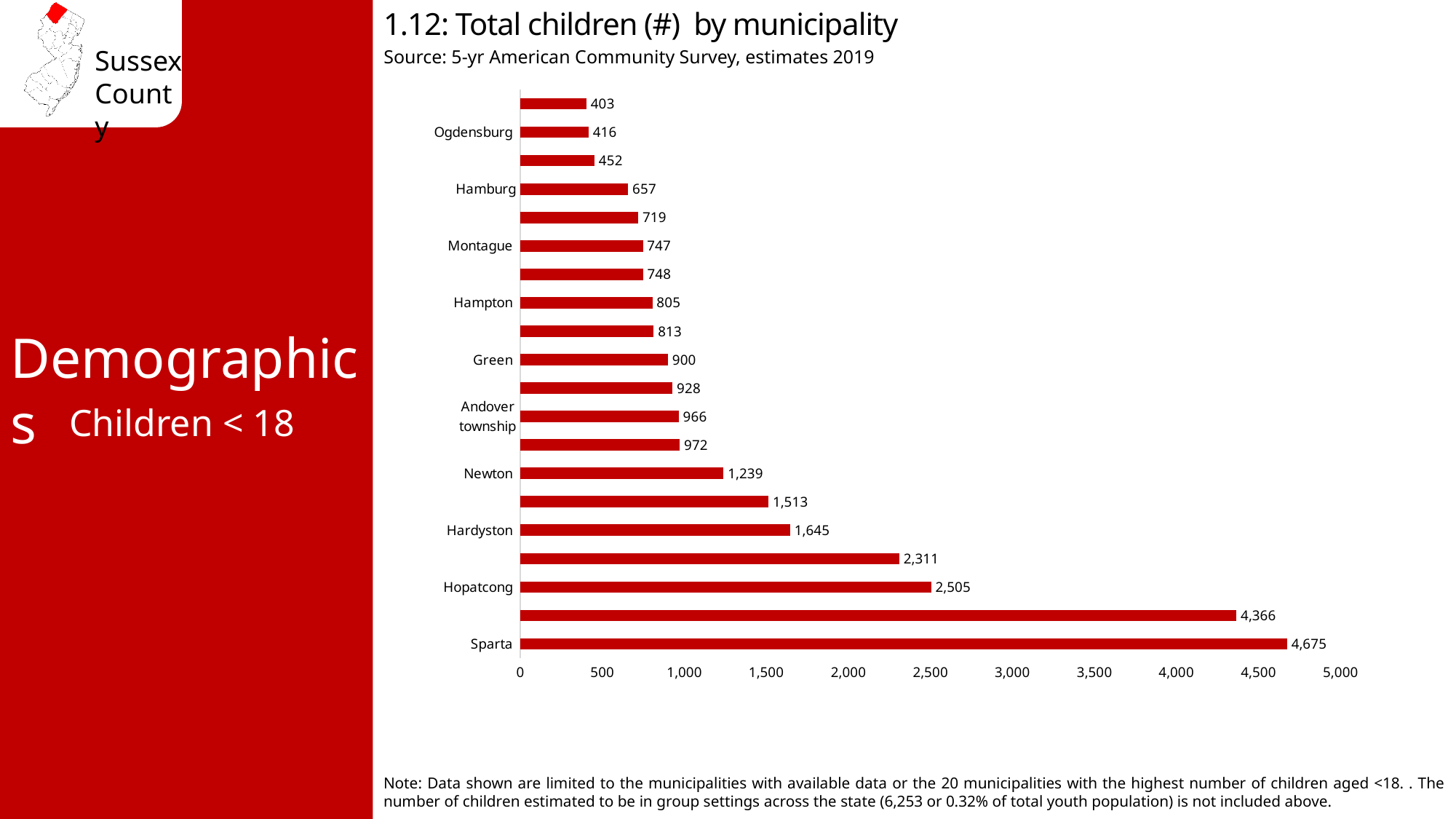
What is the difference between the values for Sparta and Hopatcong? 2,170 What is the difference between the values for Green and Hamburg? 243 What is the title of the chart? 1.12: Total children (#) by municipality What is the total number of children for Newton? 1,239 What is the total number of children for Ogdensburg? 416 What is the total number of children for Sparta? 4,675 What is the total number of children for Hopatcong? 2,505 Which labeled municipality has the highest number of children? Sparta What type of chart is shown on the slide? bar chart Which has more children, Hardyston or Hampton? Hardyston How many bars are plotted in the chart? 20 What is the smallest value shown on any bar in the chart? 403